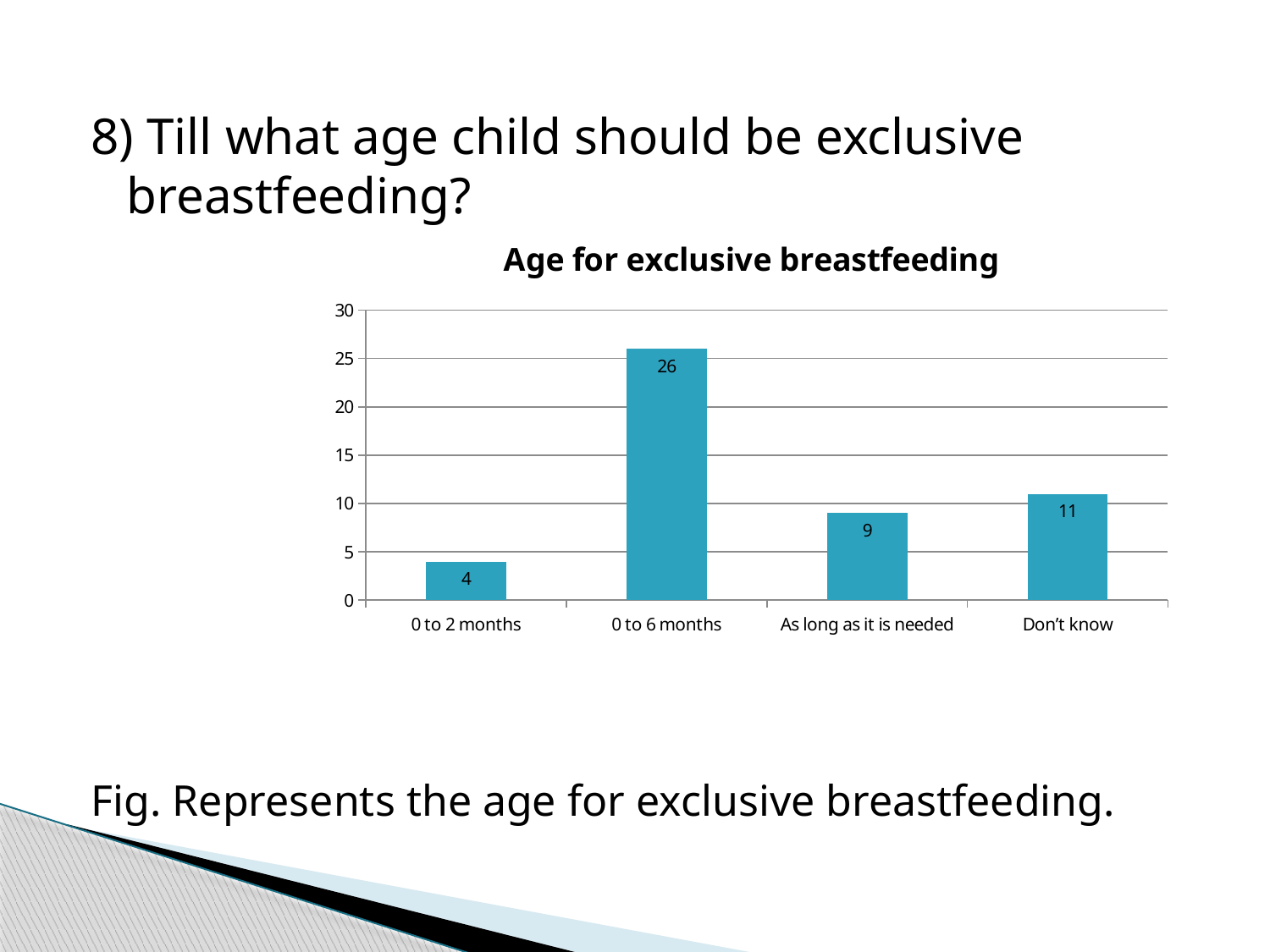
Which is larger, the value for "As long as it is needed" or the value for "Don't know"? Don't know What is the difference between the values for "0 to 6 months" and "Don't know"? 15 What is the value for "0 to 6 months"? 26 Is the value for "0 to 6 months" greater or less than 20? greater Which category has the highest value? 0 to 6 months What is the value for "As long as it is needed"? 9 Which category has the lowest value? 0 to 2 months What is the title of the chart? Age for exclusive breastfeeding How many categories are shown on the x axis? 4 What is the total of all four values shown in the chart? 50 What is the value for "Don't know"? 11 What kind of chart is shown on the slide? bar chart